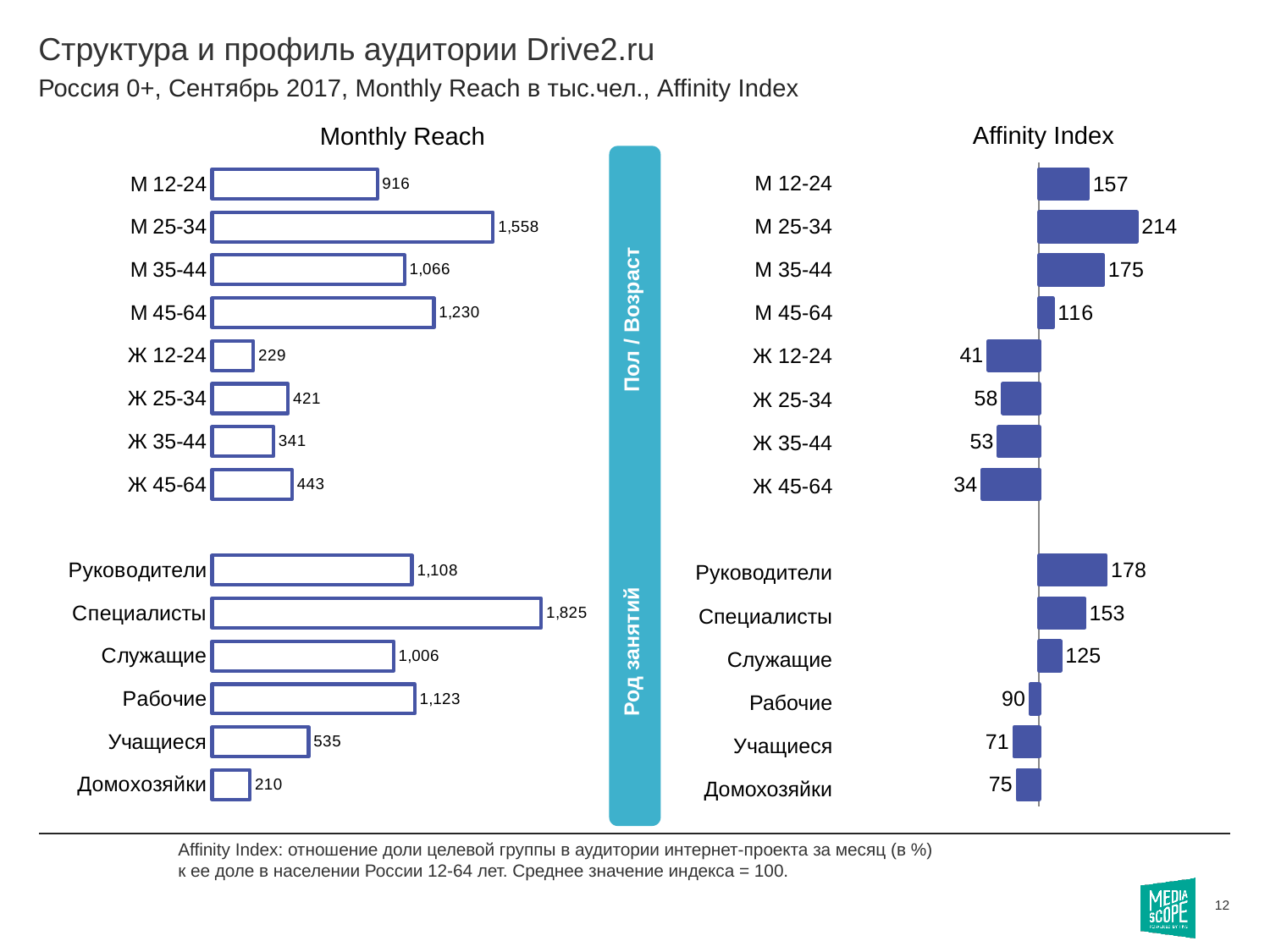
In the Monthly Reach chart, what is the value for Домохозяйки? 210 In the Affinity Index chart, which category has the lowest value? Ж 45-64 In the Monthly Reach chart, which category has the highest value? Специалисты In the Affinity Index chart, what is the difference between М 25-34 and М 45-64? 98 In the Monthly Reach chart, which category has the lowest value? Домохозяйки In the Monthly Reach chart, what is the value for М 25-34? 1,558 What kind of chart is the Monthly Reach chart? Bar chart In the Monthly Reach chart, what is the difference between М 25-34 and М 12-24? 642 In the Affinity Index chart, which is larger: Руководители or Специалисты? Руководители In the Affinity Index chart, what is the value for Ж 45-64? 34 What is the title of the chart on the right side of the slide? Affinity Index How many categories are plotted in the Affinity Index chart? 14